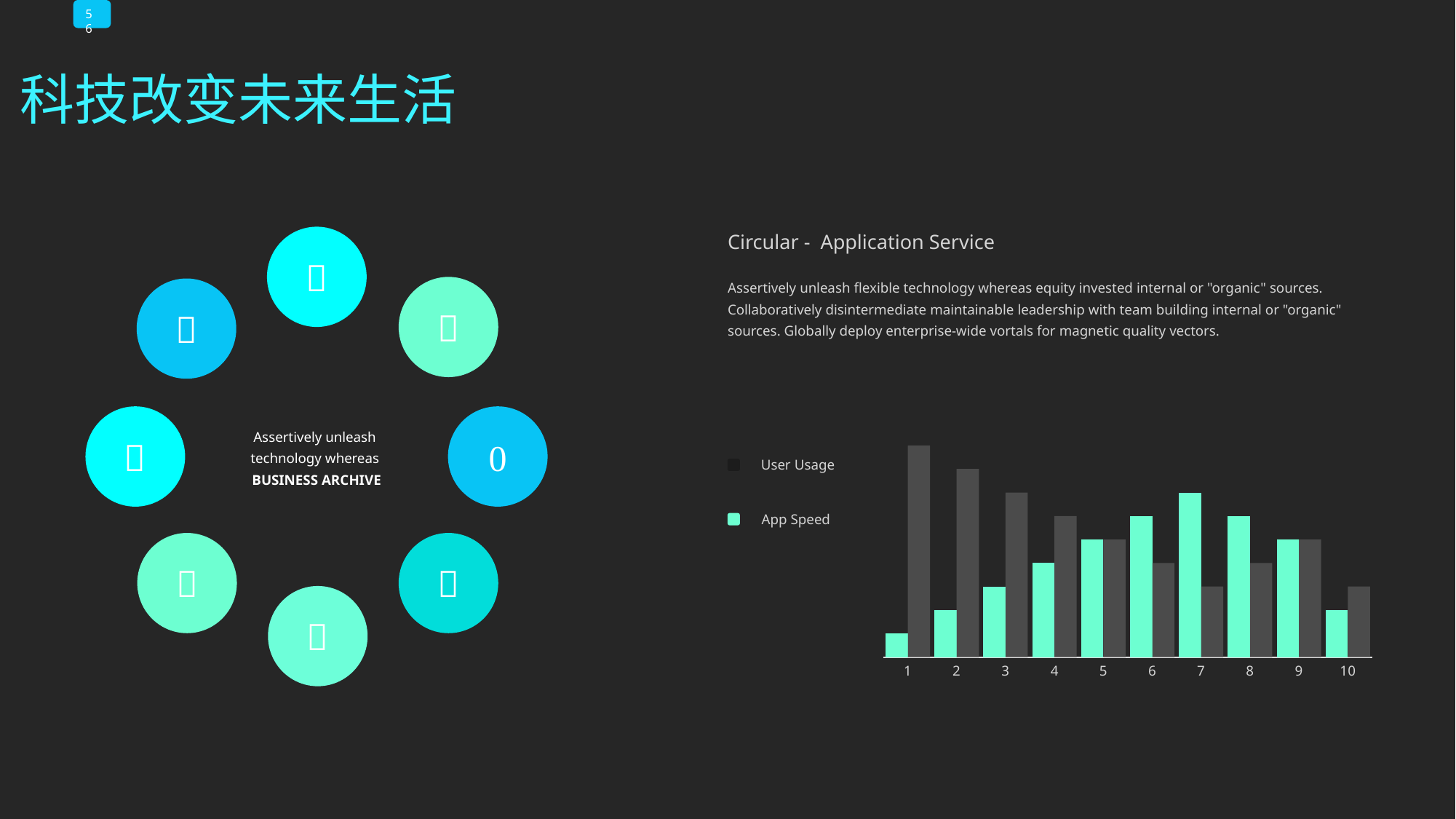
At category 1, which series has the larger value, User Usage or App Speed? User Usage What kind of chart is shown on the slide? bar chart How many series does the chart legend list? 2 At category 7, which series has the larger value, User Usage or App Speed? App Speed Which category has the highest App Speed value? 7 Which category has the highest User Usage value? 1 Do the App Speed values rise or fall from category 1 to category 7? rise How many categories are shown on the x axis of the chart? 10 What are the two series names listed in the chart legend? User Usage and App Speed Do the User Usage values rise or fall from category 1 to category 7? fall Which category has the lowest App Speed value? 1 At category 3, which series has the larger value, User Usage or App Speed? User Usage